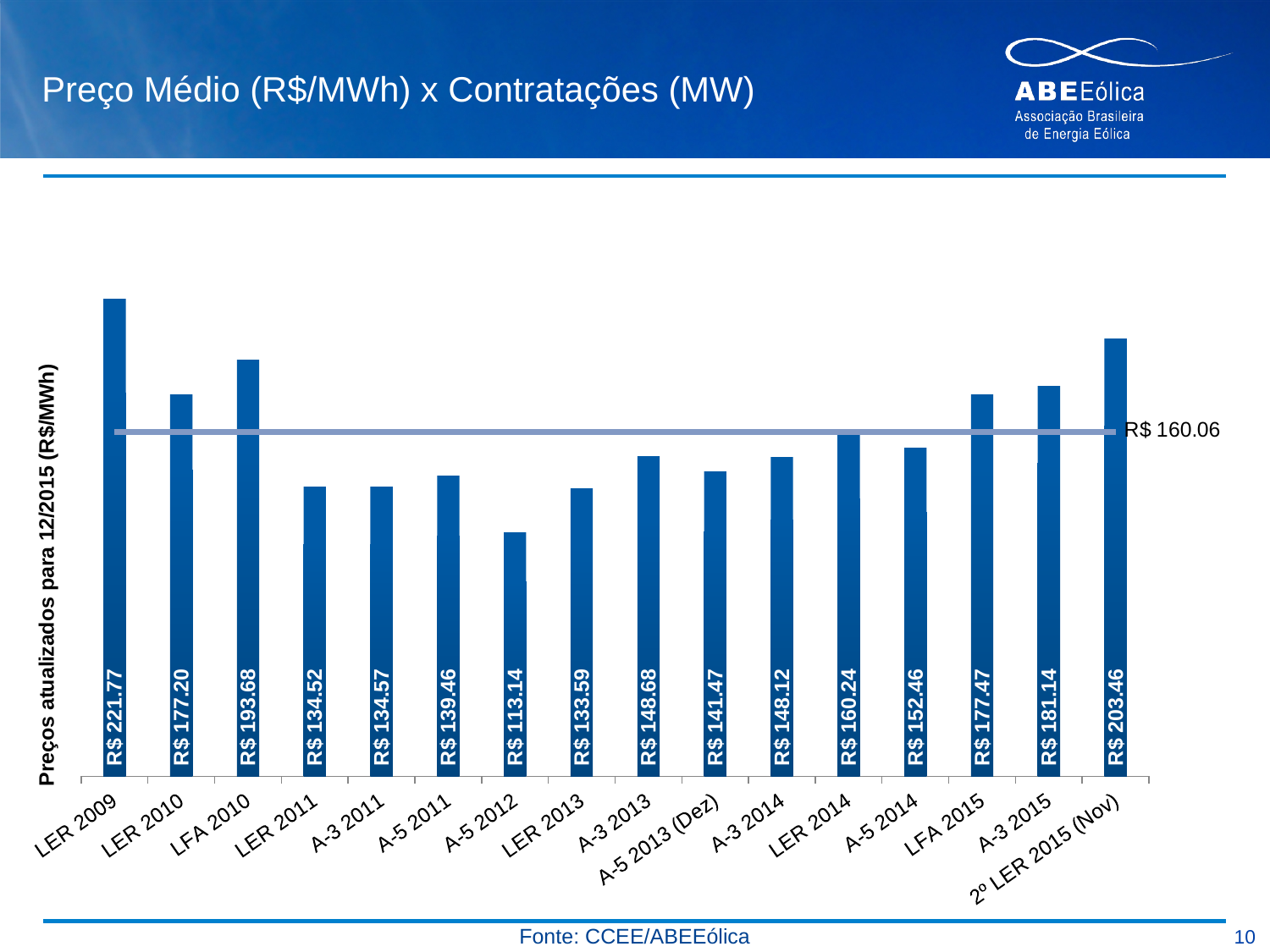
What is the value for A-5 2013 (Dez)? R$ 141.47 What kind of chart is shown on the slide? Bar chart What is the difference between the values for A-3 2015 and LFA 2015? R$ 3.67 What is the difference between the values for LER 2009 and A-5 2012? R$ 108.63 What is the value for A-5 2012? R$ 113.14 What is the value for 2º LER 2015 (Nov)? R$ 203.46 Which category has the highest value? LER 2009 Which is larger, the value for LFA 2010 or the value for 2º LER 2015 (Nov)? 2º LER 2015 (Nov) What value is marked by the horizontal line across the chart? R$ 160.06 How many bars are shown in the chart? 16 What is the value for LER 2009? R$ 221.77 Which category has the lowest value? A-5 2012